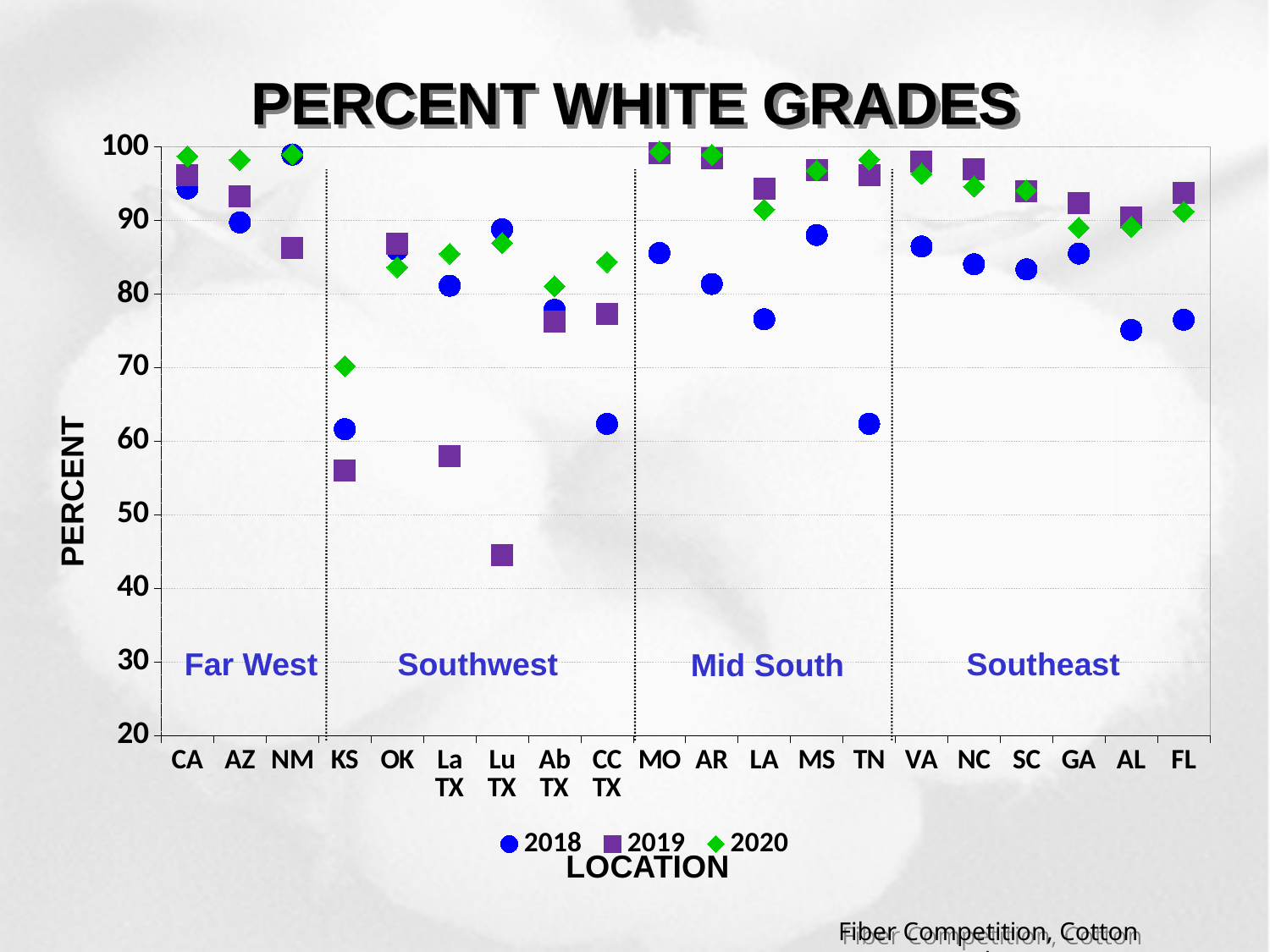
Is the 2019 value for MO greater or less than 90? greater Is the 2019 value for Lu TX greater or less than 50? less How many series does the legend list? 3 Is the 2018 value for AL greater or less than 80? less For KS, which is larger: the 2019 value or the 2020 value? 2020 What is the title of the chart? PERCENT WHITE GRADES How many locations are shown along the x axis? 20 What kind of chart is shown on the slide? scatter chart Which location has the lowest 2019 value? Lu TX Which location has the lowest 2020 value? KS For TN, which is larger: the 2018 value or the 2019 value? 2019